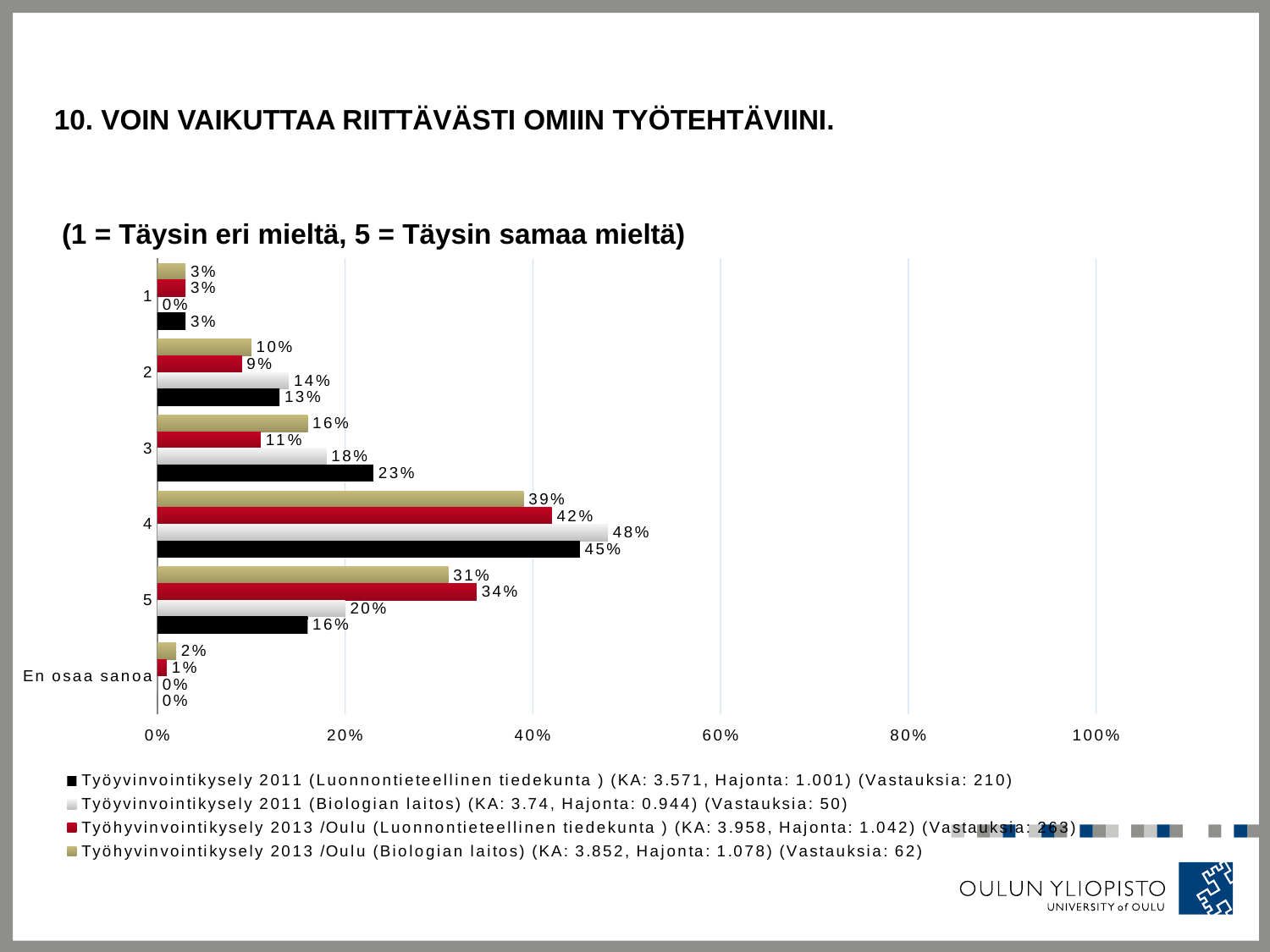
Which category has the highest value in the Työyvinvointikysely 2011 (Luonnontieteellinen tiedekunta) series? 4 How many categories are shown on the vertical axis? 6 What is the difference between the Työyvinvointikysely 2011 (Biologian laitos) value and the Työhyvinvointikysely 2013 /Oulu (Biologian laitos) value for category 5? 11% What is the value for category 5 in the Työhyvinvointikysely 2013 /Oulu (Luonnontieteellinen tiedekunta) series? 34% What is the value for category 4 in the Työyvinvointikysely 2011 (Biologian laitos) series? 48% Is the value for category 4 in the Työyvinvointikysely 2011 (Biologian laitos) series greater or less than 40%? greater What is the value for category 3 in the Työyvinvointikysely 2011 (Luonnontieteellinen tiedekunta) series? 23% How many series does the legend list? 4 What is the value for category 2 in the Työhyvinvointikysely 2013 /Oulu (Biologian laitos) series? 10% For category 3, which is larger: the Työyvinvointikysely 2011 (Luonnontieteellinen tiedekunta) value or the Työhyvinvointikysely 2013 /Oulu (Luonnontieteellinen tiedekunta) value? Työyvinvointikysely 2011 (Luonnontieteellinen tiedekunta) What kind of chart is shown on the slide? bar chart What is the value for En osaa sanoa in the Työhyvinvointikysely 2013 /Oulu (Biologian laitos) series? 2%